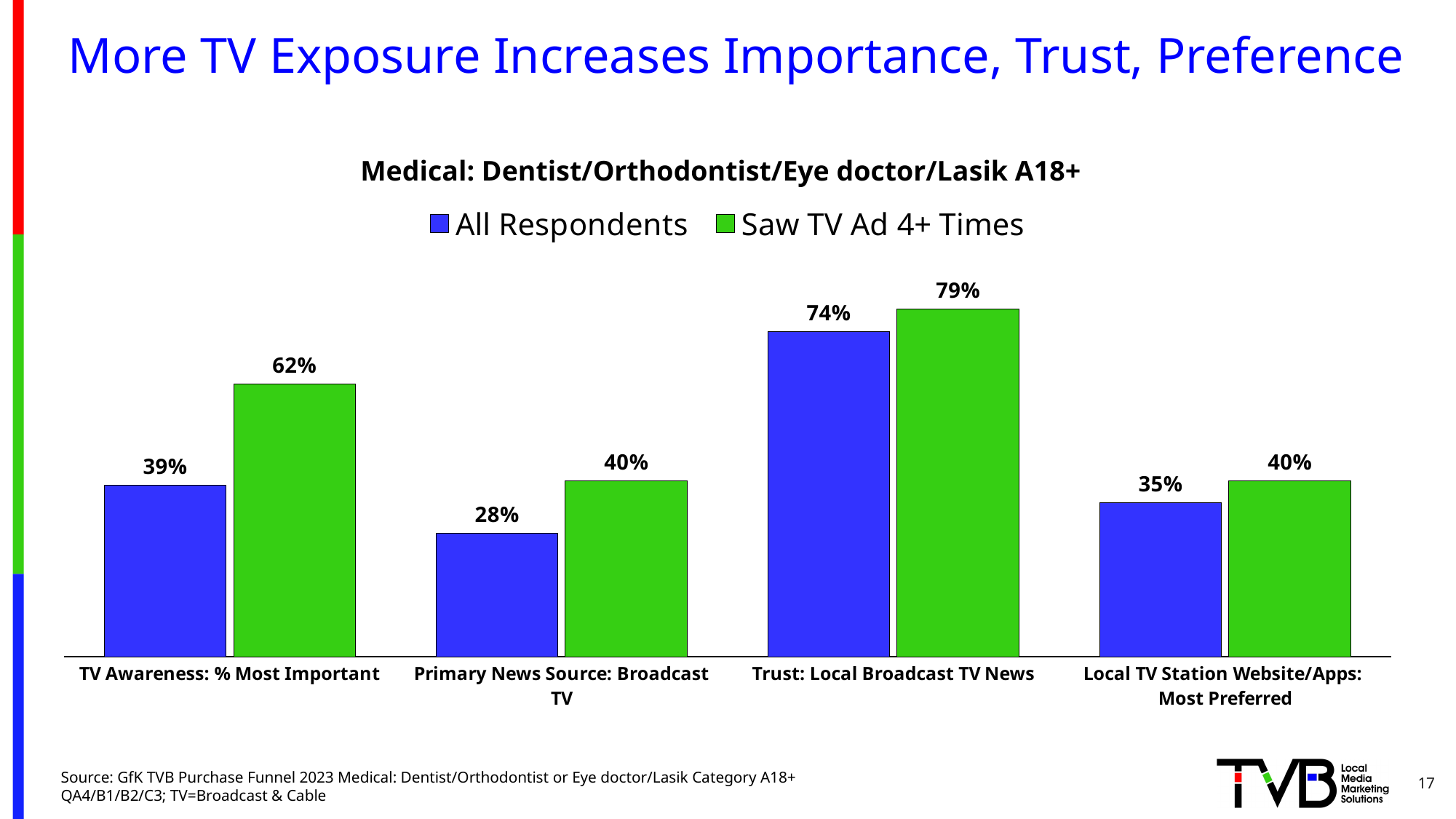
How many series does the legend list? 2 What is the value for All Respondents in the Primary News Source: Broadcast TV category? 28% What is the value for Saw TV Ad 4+ Times in the Trust: Local Broadcast TV News category? 79% Which category has the lowest value for Saw TV Ad 4+ Times? Primary News Source: Broadcast TV and Local TV Station Website/Apps: Most Preferred (both 40%) Which colour represents the Saw TV Ad 4+ Times series? Green What is the title of the chart? Medical: Dentist/Orthodontist/Eye doctor/Lasik A18+ Which is larger in the Local TV Station Website/Apps: Most Preferred category: All Respondents or Saw TV Ad 4+ Times? Saw TV Ad 4+ Times What is the difference between Saw TV Ad 4+ Times and All Respondents in the TV Awareness: % Most Important category? 23% Which category has the highest value for All Respondents? Trust: Local Broadcast TV News How many categories are shown on the x axis? 4 What kind of chart is shown on the slide? Bar chart What is the value for All Respondents in the TV Awareness: % Most Important category? 39%